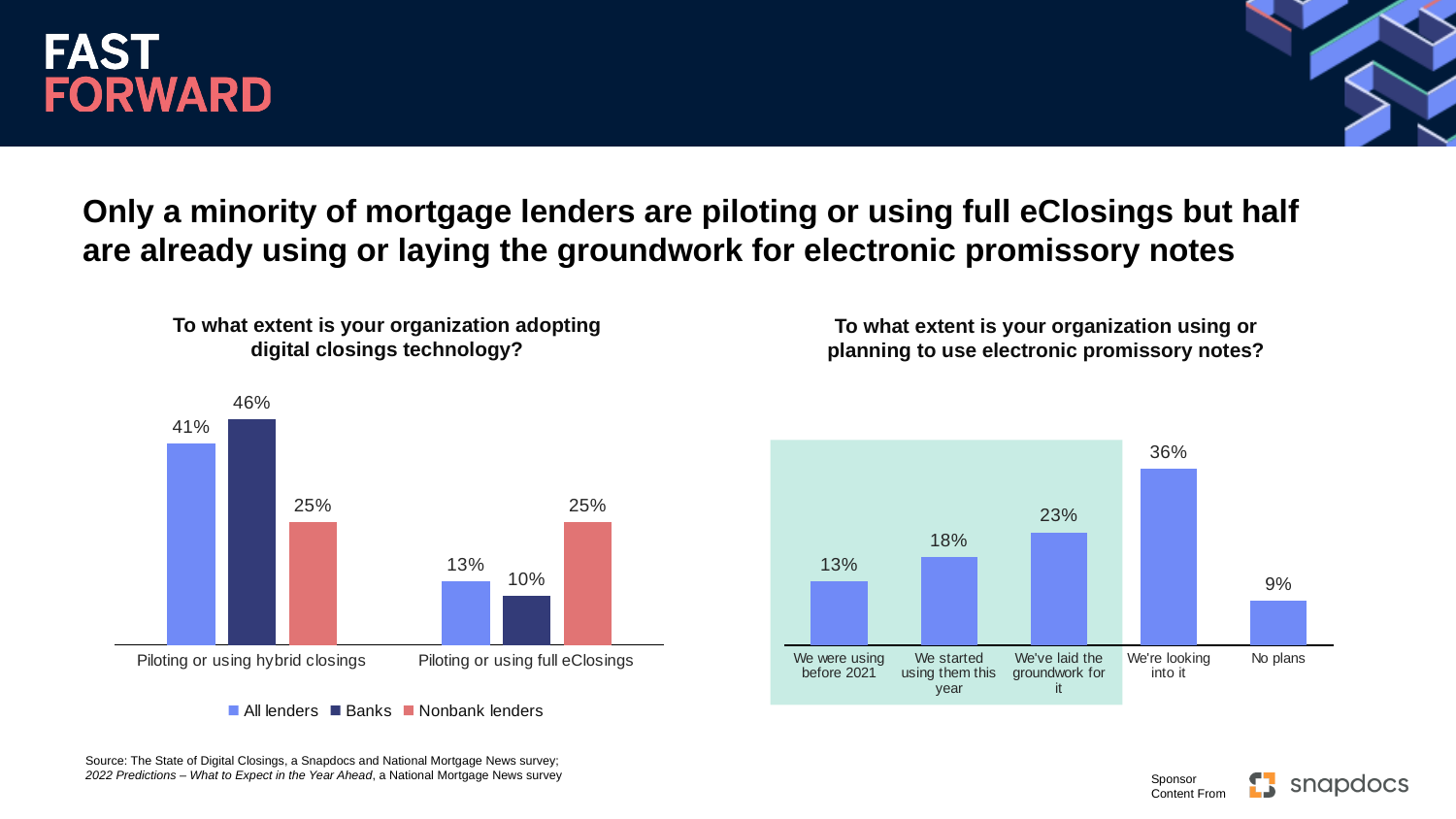
In the chart 'To what extent is your organization adopting digital closings technology?', how many series does the legend list? 3 In the chart 'To what extent is your organization using or planning to use electronic promissory notes?', what is the total of the three highlighted categories ('We were using before 2021', 'We started using them this year', 'We've laid the groundwork for it')? 54% In the chart 'To what extent is your organization using or planning to use electronic promissory notes?', what is the value for 'We're looking into it'? 36% In the chart 'To what extent is your organization adopting digital closings technology?', which is larger for Nonbank lenders: hybrid closings or full eClosings? They are equal (25%) In the chart 'To what extent is your organization adopting digital closings technology?', what is the value for Banks for 'Piloting or using hybrid closings'? 46% In the chart 'To what extent is your organization using or planning to use electronic promissory notes?', which category has the highest value? We're looking into it In the chart 'To what extent is your organization using or planning to use electronic promissory notes?', which category has the lowest value? No plans In the chart 'To what extent is your organization adopting digital closings technology?', which series has the lowest value for 'Piloting or using full eClosings'? Banks What kind of chart is 'To what extent is your organization using or planning to use electronic promissory notes?'? Bar chart In the chart 'To what extent is your organization adopting digital closings technology?', what is the value for All lenders for 'Piloting or using full eClosings'? 13% In the chart 'To what extent is your organization using or planning to use electronic promissory notes?', how many categories are shown? 5 In the chart 'To what extent is your organization adopting digital closings technology?', what is the difference between All lenders and Nonbank lenders for 'Piloting or using hybrid closings'? 16%